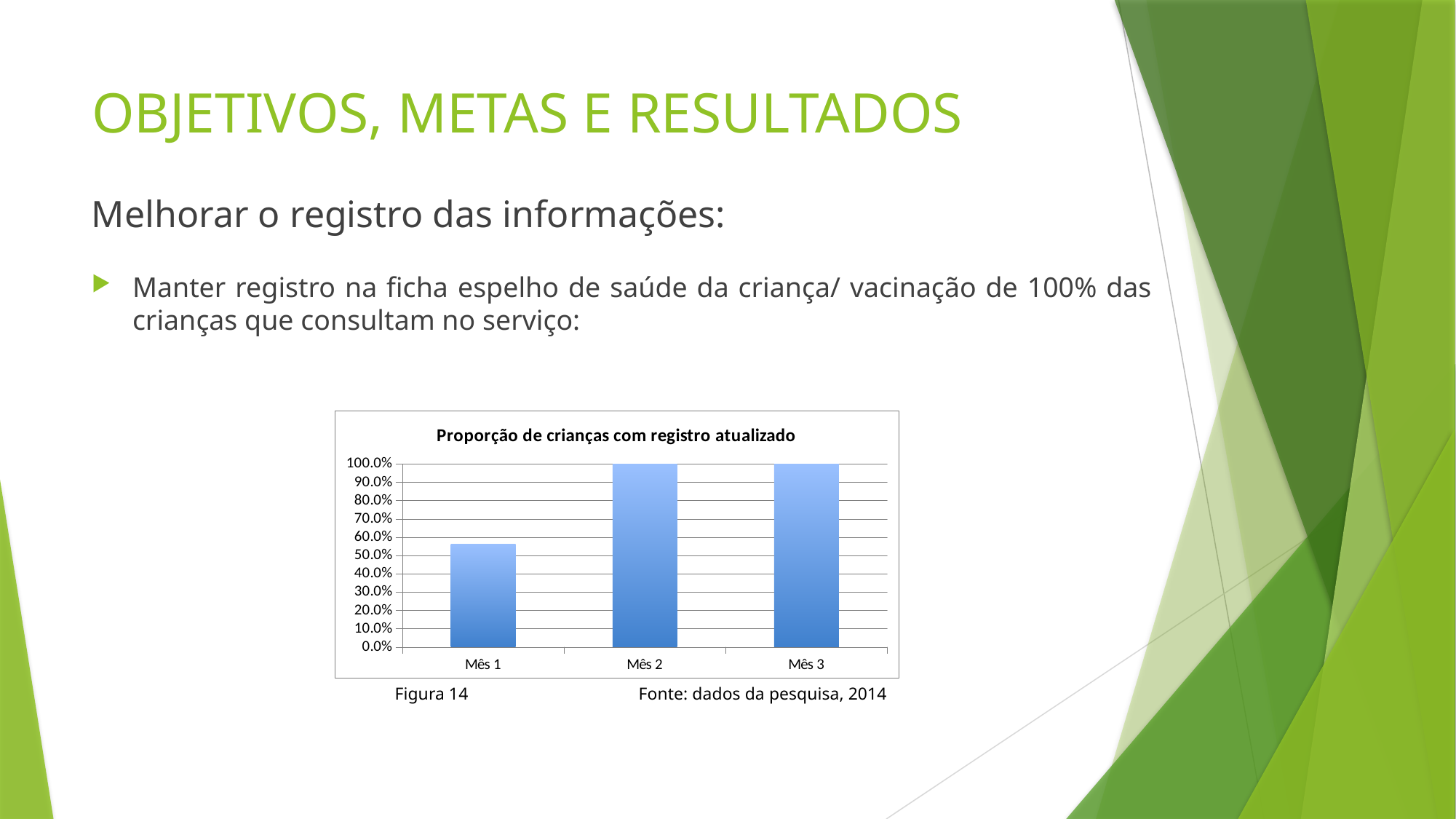
Does the value rise or fall from Mês 1 to Mês 2? rise Which month has the lowest proportion of children with updated records? Mês 1 Which is larger, the value for Mês 1 or the value for Mês 2? Mês 2 Is the value for Mês 1 greater or less than 50.0%? greater What is the value for Mês 3? 100.0% Is the value for Mês 1 greater or less than 60.0%? less What is the figure number given below the chart? Figura 14 What is the value for Mês 2? 100.0% How many months (categories) are shown on the x axis of the chart? 3 What kind of chart is shown on the slide? bar chart What is the title of the chart? Proporção de crianças com registro atualizado